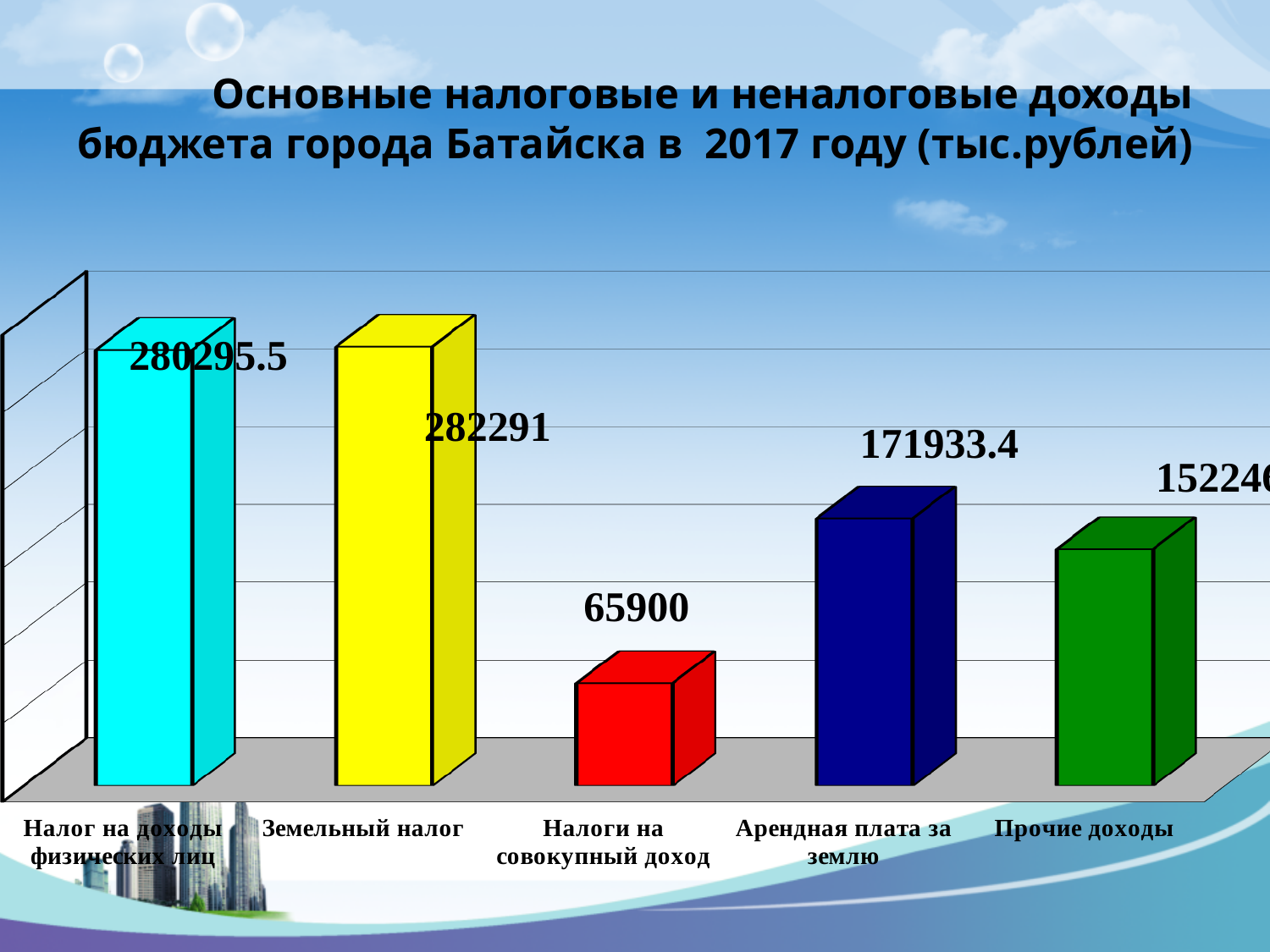
How many categories are shown in the chart? 5 Which is larger: Арендная плата за землю or Прочие доходы? Арендная плата за землю What is the difference between the values for Арендная плата за землю and Налоги на совокупный доход? 106033.4 What is the value for Налог на доходы физических лиц? 280295.5 What is the value for Налоги на совокупный доход? 65900 What kind of chart is shown on the slide? Bar chart What is the value for Земельный налог? 282291 What is the value for Арендная плата за землю? 171933.4 In what units are the values in the chart expressed, according to the title? тыс.рублей Which category has the highest value? Земельный налог Which category has the lowest value? Налоги на совокупный доход What is the difference between the values for Земельный налог and Налог на доходы физических лиц? 1995.5